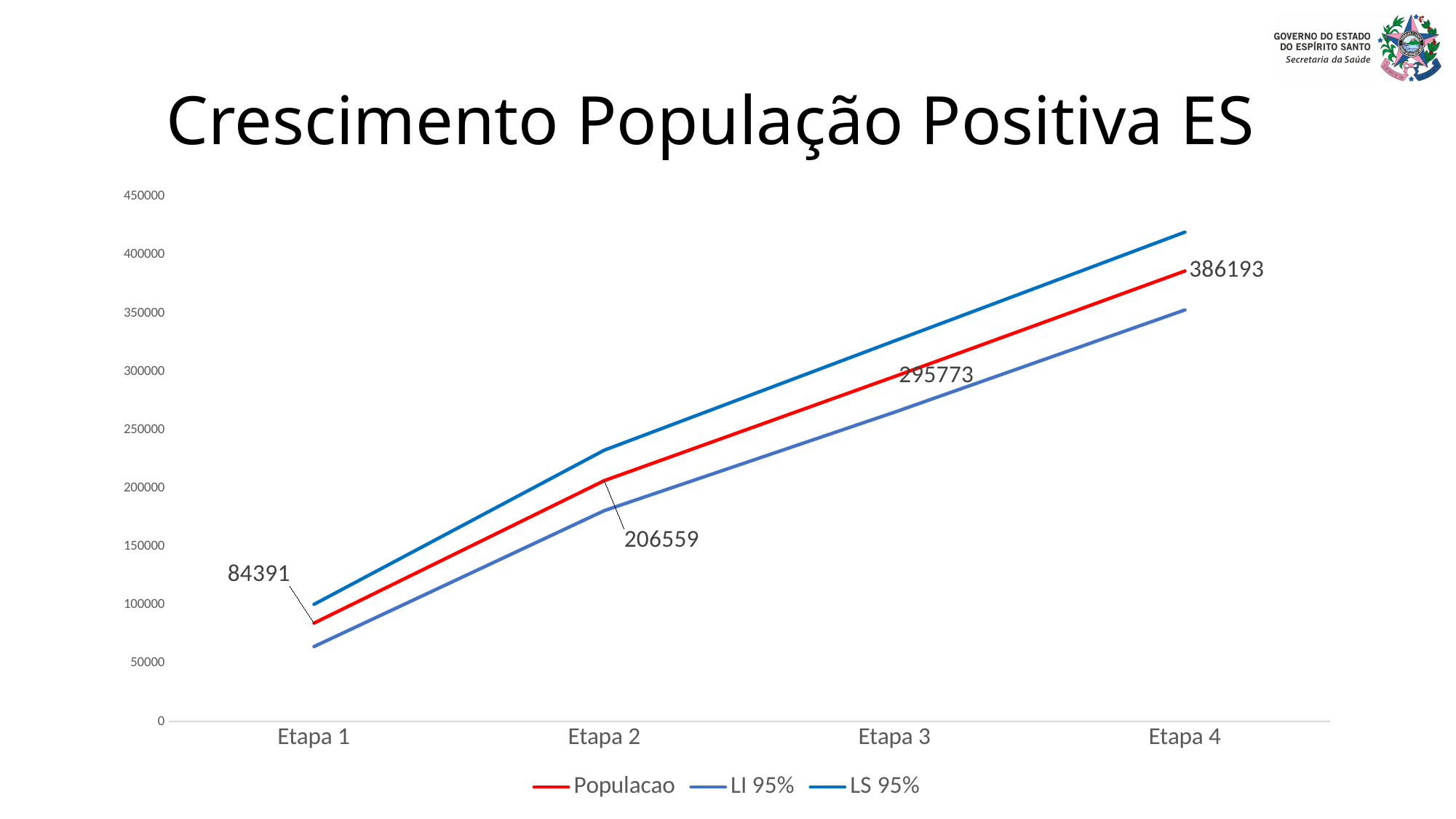
At which Etapa is the Populacao series lowest? Etapa 1 What is the Populacao value at Etapa 4? 386193 What is the Populacao value at Etapa 1? 84391 What is the difference between the Populacao values at Etapa 4 and Etapa 1? 301802 Is the LI 95% value at Etapa 1 greater or less than 100000? less How many Etapas are shown on the x axis? 4 At which Etapa is the Populacao series highest? Etapa 4 What is the Populacao value at Etapa 2? 206559 How many series does the legend list? 3 What is the difference between the Populacao values at Etapa 3 and Etapa 2? 89214 Is the LS 95% value at Etapa 4 greater or less than 400000? greater Does the Populacao series rise or fall from Etapa 1 to Etapa 4? rise